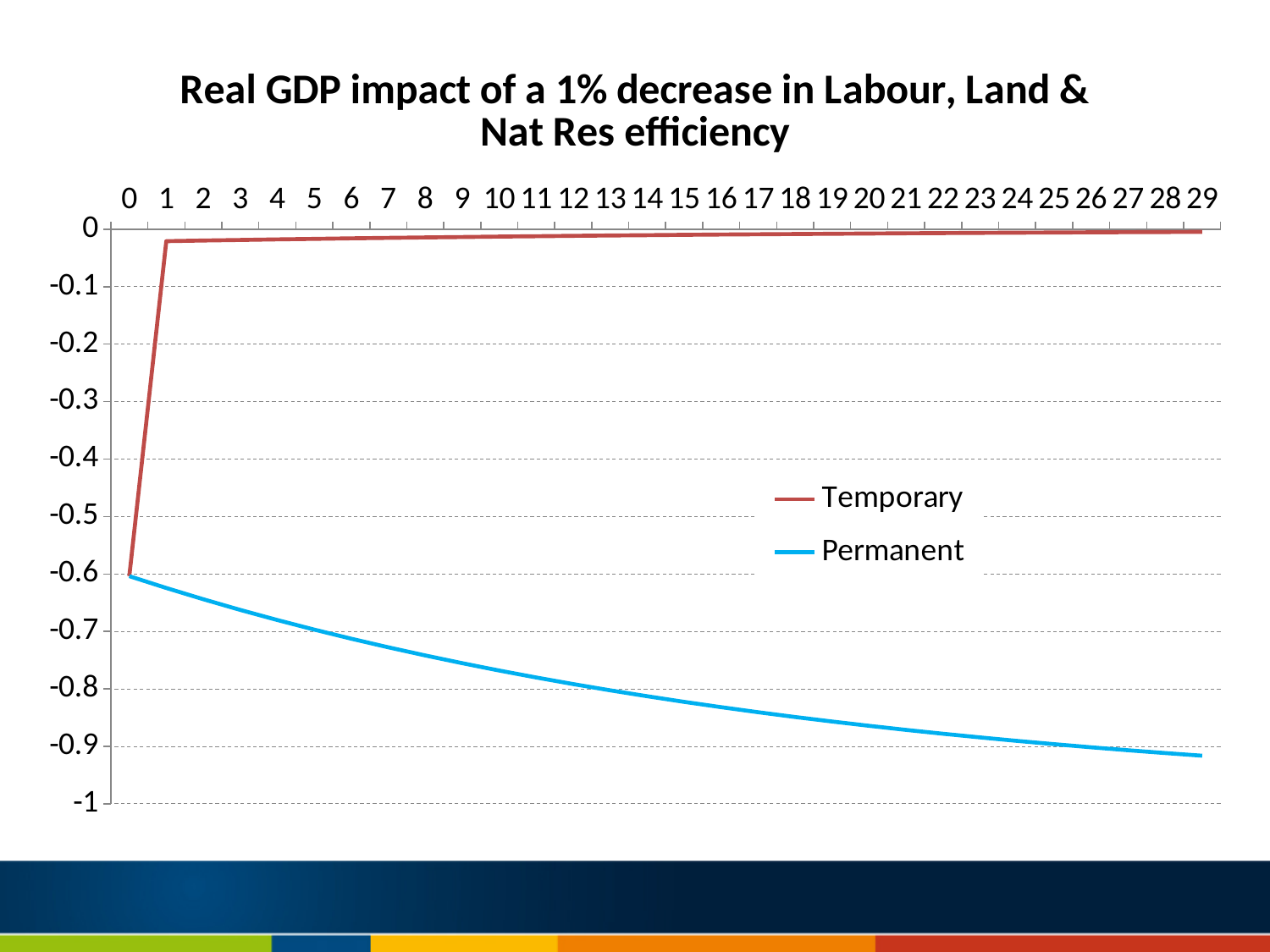
What kind of chart is shown on the slide? line chart Does the Permanent series rise or fall as the x axis goes from 0 to 29? fall How many points are plotted along the x axis for each series? 30 Does the Temporary series rise or fall as the x axis goes from 1 to 29? rise How many series does the legend list? 2 Is the value of the Permanent series at x = 29 greater or less than -0.9? less What is the title of the chart? Real GDP impact of a 1% decrease in Labour, Land & Nat Res efficiency What are the two series named in the legend? Temporary and Permanent Is the value of the Temporary series at x = 10 greater or less than -0.1? greater Is the value of the Permanent series at x = 5 greater or less than -0.8? greater At x = 15, which series has the higher value, Temporary or Permanent? Temporary